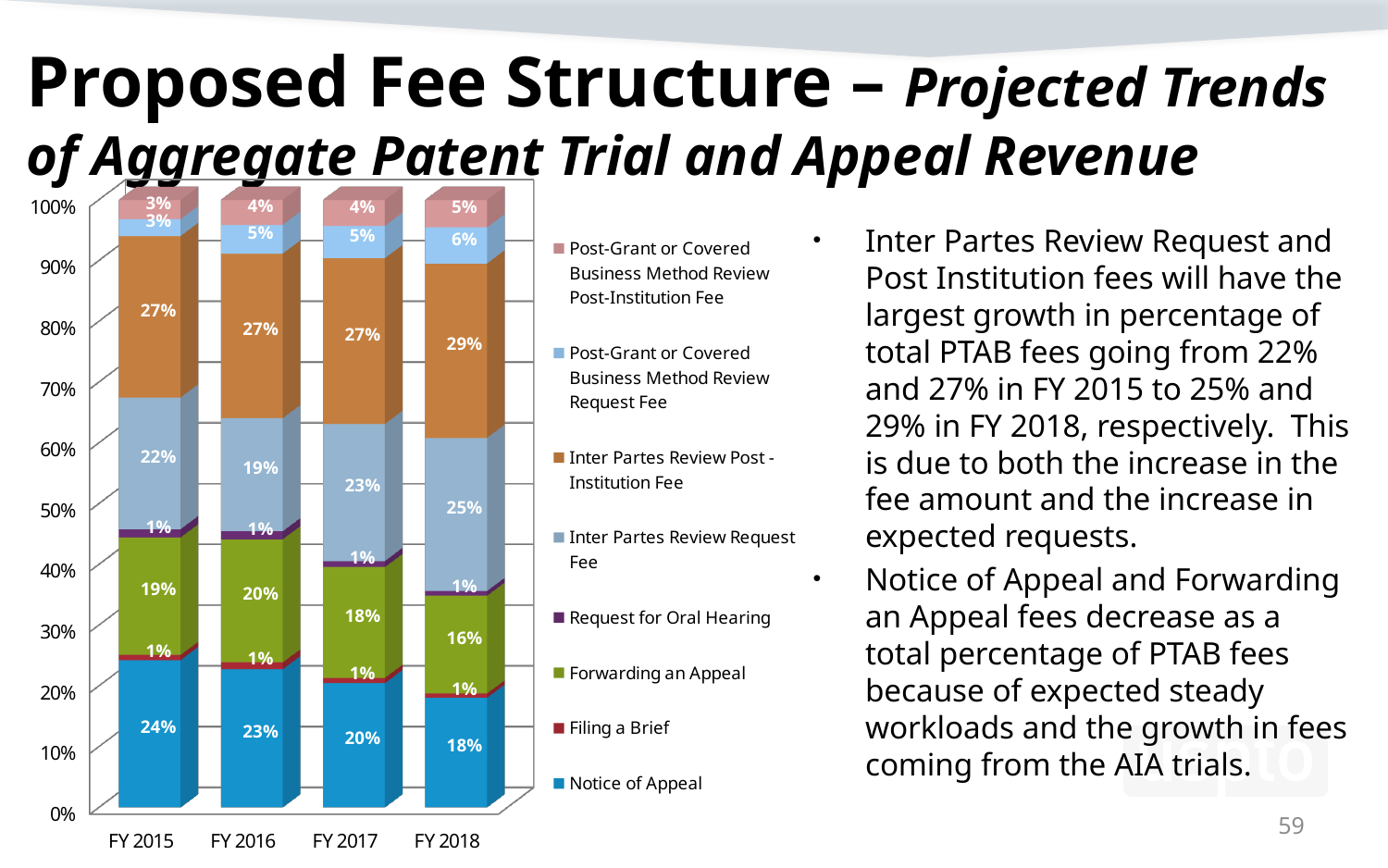
What is the Forwarding an Appeal share in FY 2017? 18% Which is larger in FY 2017: the Inter Partes Review Request Fee share or the Forwarding an Appeal share? Inter Partes Review Request Fee How many fiscal years are shown on the x axis of the chart? 4 What is the Inter Partes Review Request Fee share in FY 2016? 19% What is the Inter Partes Review Post-Institution Fee share in FY 2018? 29% What is the difference between the Notice of Appeal share in FY 2015 and in FY 2018? 6% In which fiscal year is the Notice of Appeal share lowest? FY 2018 What kind of chart is shown on the slide? Stacked bar chart How many series does the chart's legend list? 8 Does the Notice of Appeal share rise or fall from FY 2015 to FY 2018? Fall In which fiscal year is the Inter Partes Review Request Fee share highest? FY 2018 What is the Notice of Appeal share in FY 2015? 24%